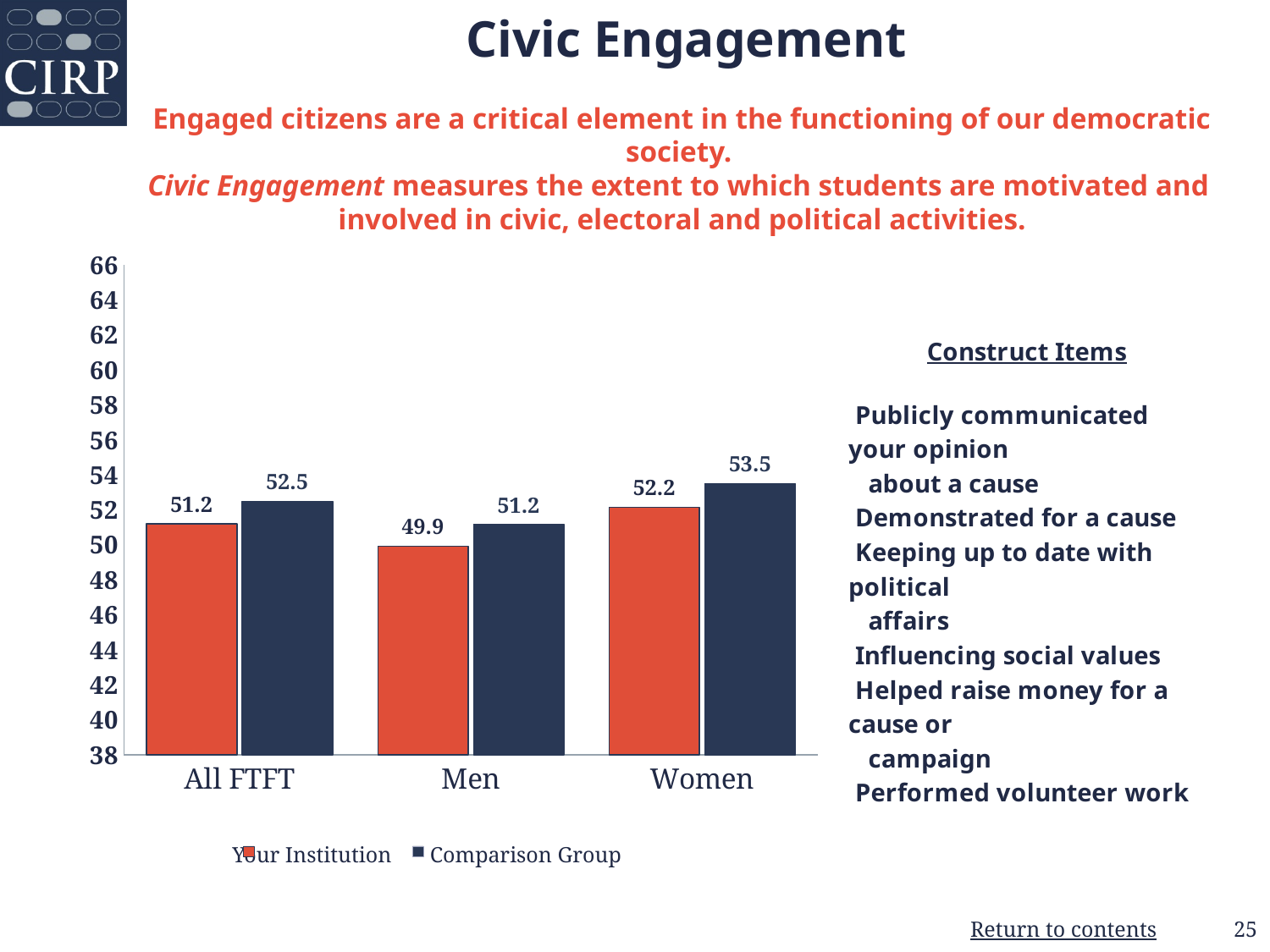
Which category has the lowest Your Institution value? Men What is the Your Institution value for All FTFT? 51.2 For Men, which is larger: Your Institution or Comparison Group? Comparison Group Which category has the highest Comparison Group value? Women What is the difference between the Comparison Group and Your Institution values for All FTFT? 1.3 What is the Comparison Group value for Men? 51.2 How many series does the legend list? 2 What is the Your Institution value for Men? 49.9 What kind of chart is shown on the slide? Bar chart What is the Comparison Group value for Women? 53.5 What is the difference between the Comparison Group and Your Institution values for Women? 1.3 How many categories are shown on the x axis? 3